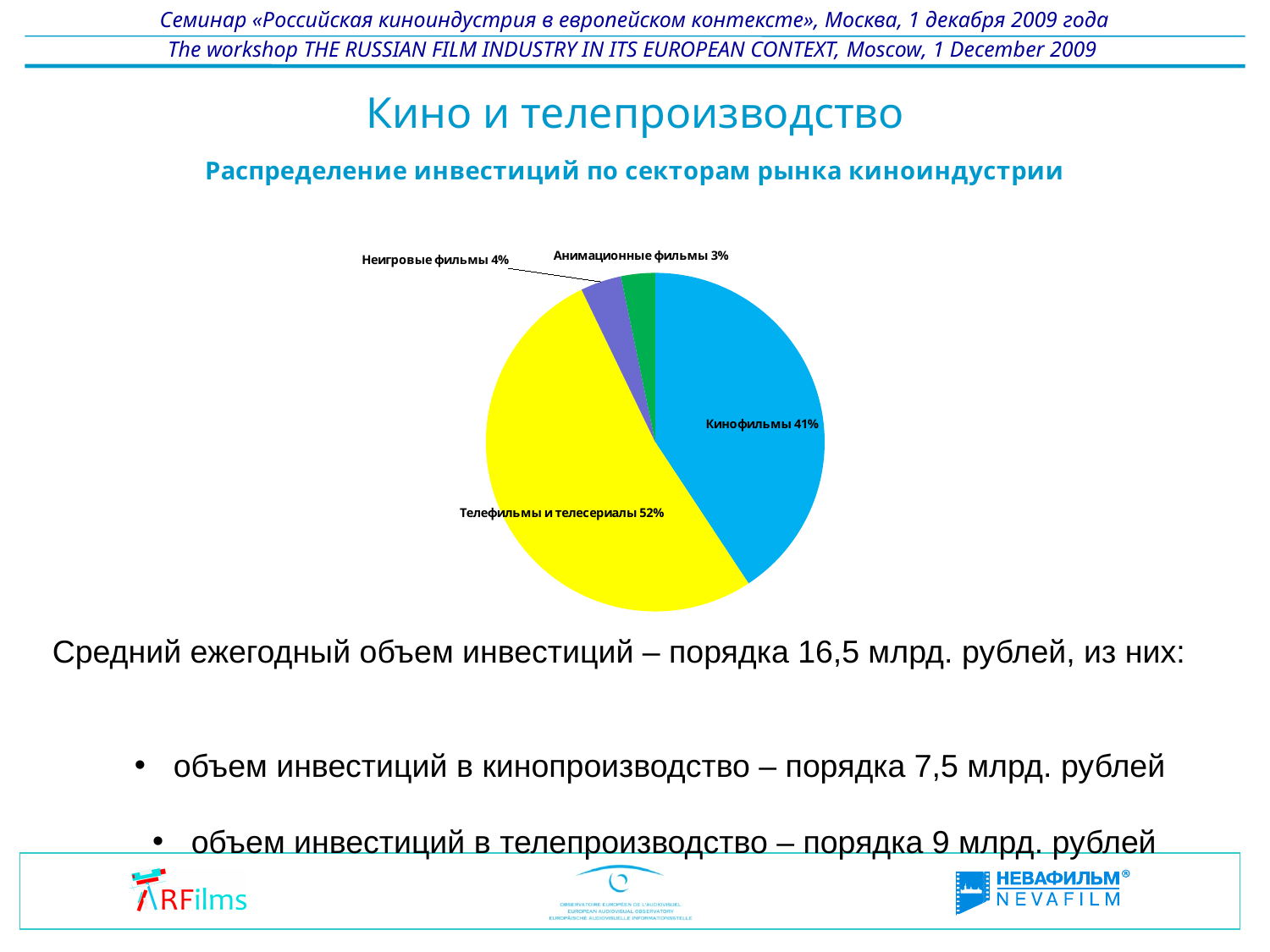
Which sector has the largest share of investment? Телефильмы и телесериалы Which sector has the smallest share of investment? Анимационные фильмы What colour is the Кинофильмы slice? Blue What share of investment goes to Кинофильмы? 41% What is the difference in share between Неигровые фильмы and Анимационные фильмы? 1% What kind of chart is shown on the slide? Pie chart What share of investment goes to Телефильмы и телесериалы? 52% What is the difference in share between Телефильмы и телесериалы and Кинофильмы? 11% Which has a larger share: Кинофильмы or Неигровые фильмы? Кинофильмы What share of investment goes to Неигровые фильмы? 4% How many sectors are shown in the pie chart? 4